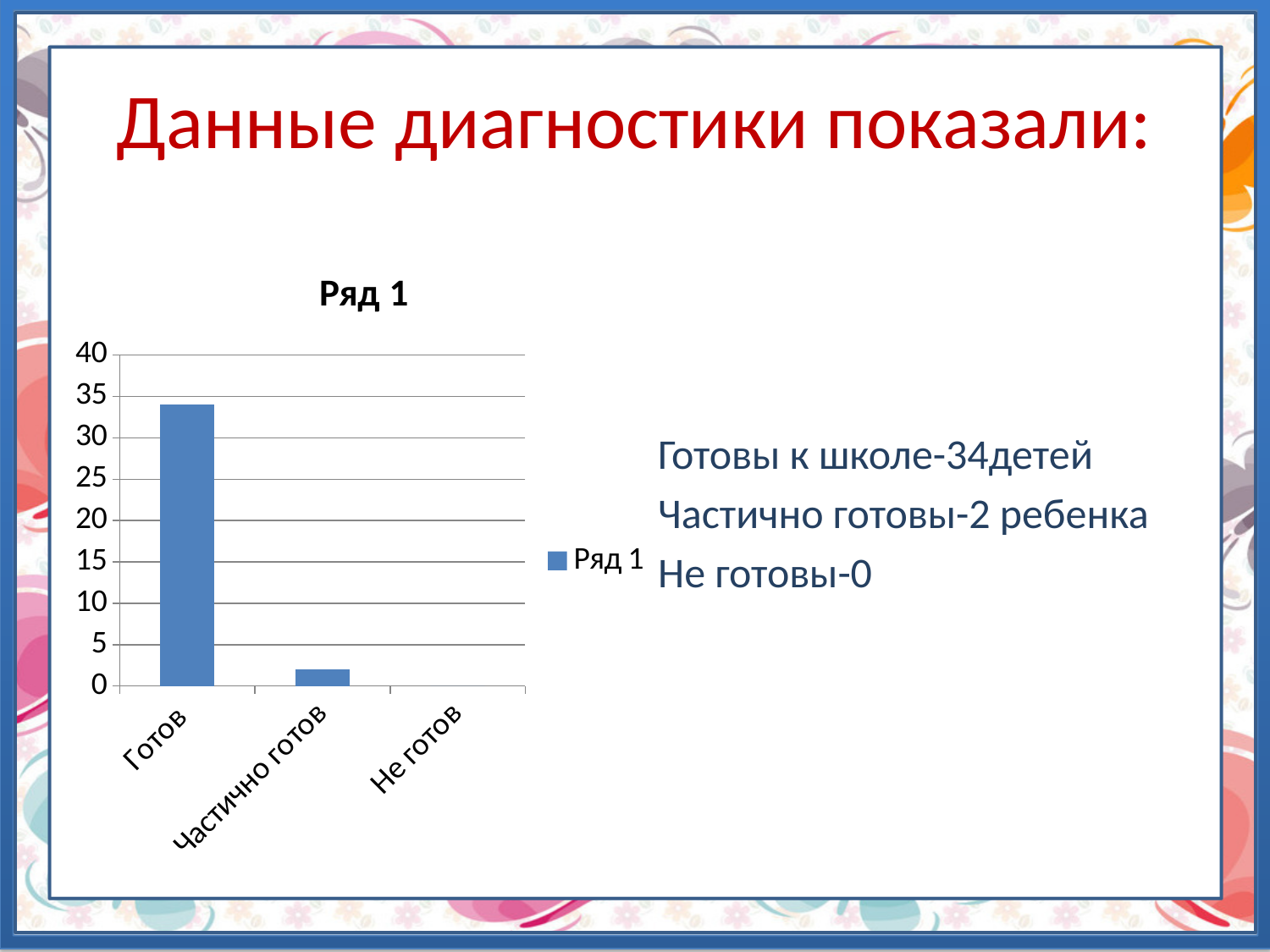
How many categories are shown on the x axis of the chart? 3 What is the title of the chart? Ряд 1 According to the slide, how many children are partially ready (Частично готовы)? 2 Is the value for Готов greater or less than 30? greater Which category has the highest bar in the chart? Готов Is the value for Частично готов greater or less than 5? less What is the value for Не готов in the chart? 0 According to the slide, how many children are ready for school (Готовы к школе)? 34 How many series does the chart legend list? 1 Which category has the lowest bar in the chart? Не готов What kind of chart is shown on the slide? bar chart Which is larger, the value for Готов or the value for Частично готов? Готов